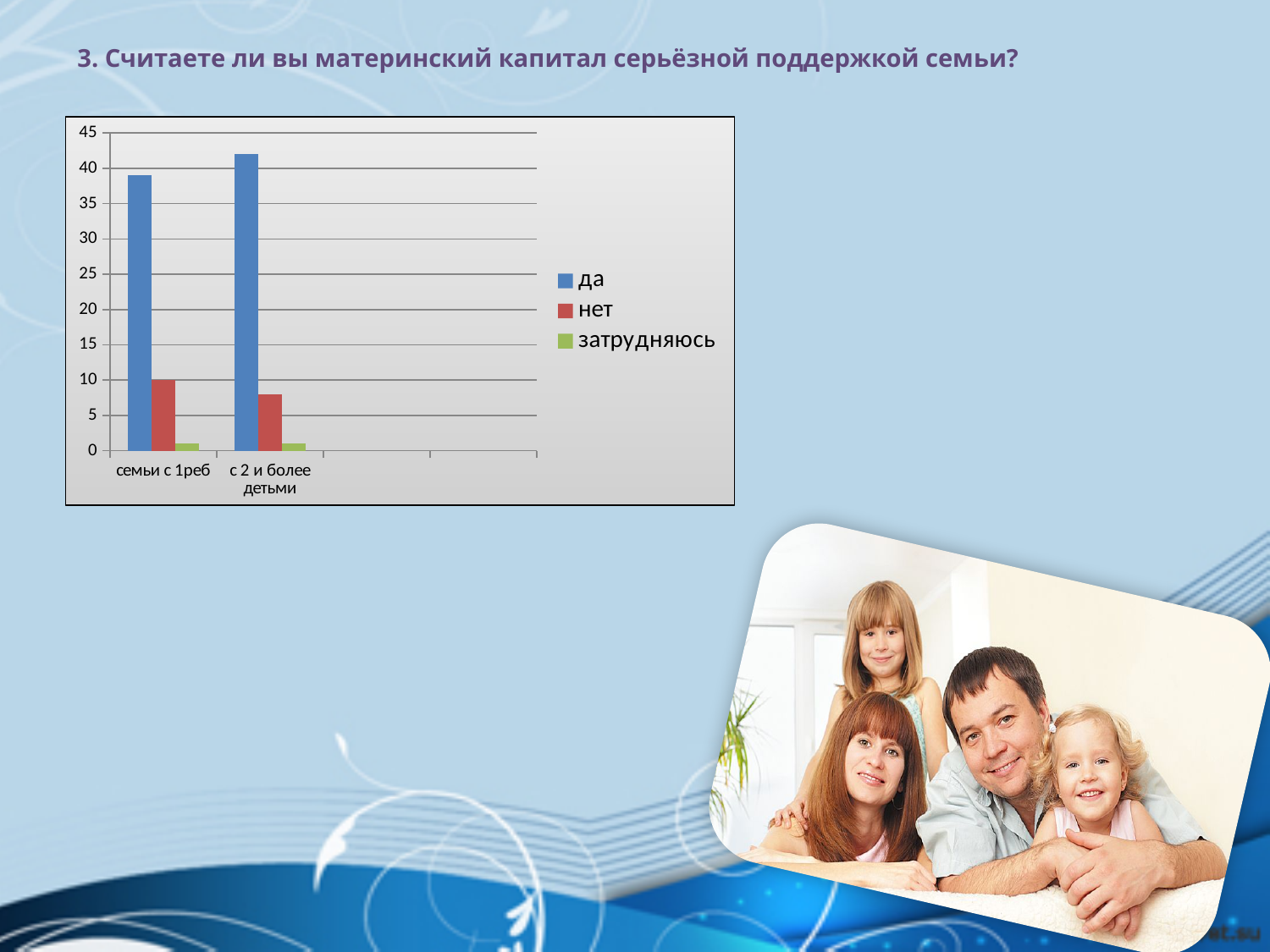
Which colour represents the series "нет" in the legend? red Which series has the lowest value in the category "семьи с 1реб"? затрудняюсь Is the value for "затрудняюсь" in the category "семьи с 1реб" greater or less than 5? less Which series has the highest value in the category "с 2 и более детьми"? да What kind of chart is shown on the slide? bar chart Is the value for "да" in the category "семьи с 1реб" greater or less than 35? greater How many categories are shown on the x axis? 2 Which is larger: the value for "да" in "семьи с 1реб" or the value for "да" in "с 2 и более детьми"? с 2 и более детьми Is the value for "да" in the category "с 2 и более детьми" greater or less than 40? greater How many series does the legend list? 3 What is the value for "нет" in the category "семьи с 1реб"? 10